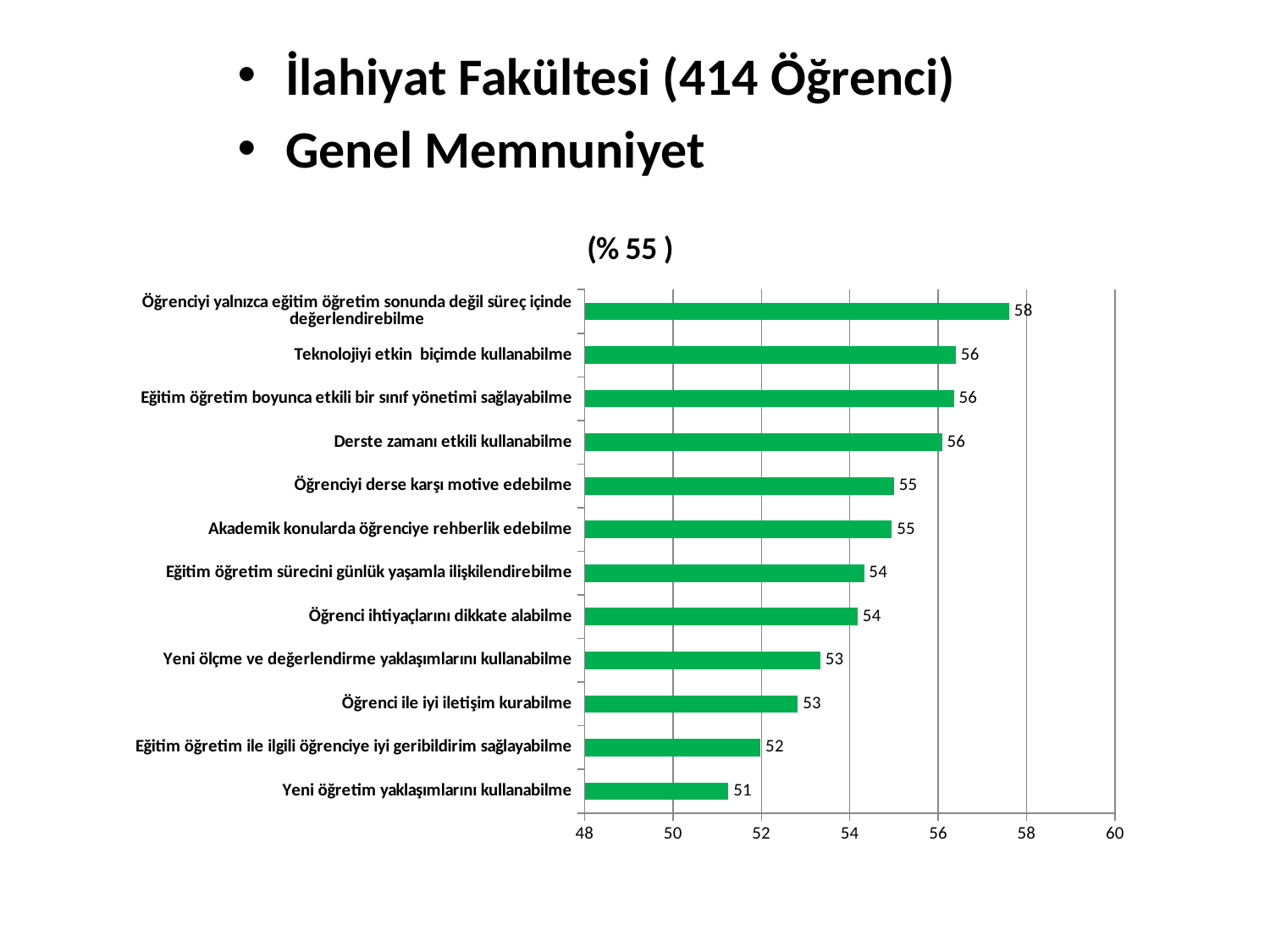
Which category has the highest value? Öğrenciyi yalnızca eğitim öğretim sonunda değil süreç içinde değerlendirebilme What is the title of the chart? (% 55 ) What is the value for "Öğrenciyi yalnızca eğitim öğretim sonunda değil süreç içinde değerlendirebilme"? 58 Is the value for "Öğrenci ile iyi iletişim kurabilme" greater or less than 54? less What is the value for "Eğitim öğretim ile ilgili öğrenciye iyi geribildirim sağlayabilme"? 52 What is the value for "Yeni öğretim yaklaşımlarını kullanabilme"? 51 Which category has the lowest value? Yeni öğretim yaklaşımlarını kullanabilme What kind of chart is shown on the slide? bar chart How many categories are shown in the chart? 12 What is the difference between the highest value (58) and the lowest value (51)? 7 Which is larger: the value for "Teknolojiyi etkin biçimde kullanabilme" or the value for "Yeni öğretim yaklaşımlarını kullanabilme"? Teknolojiyi etkin biçimde kullanabilme What is the value for "Öğrenci ihtiyaçlarını dikkate alabilme"? 54